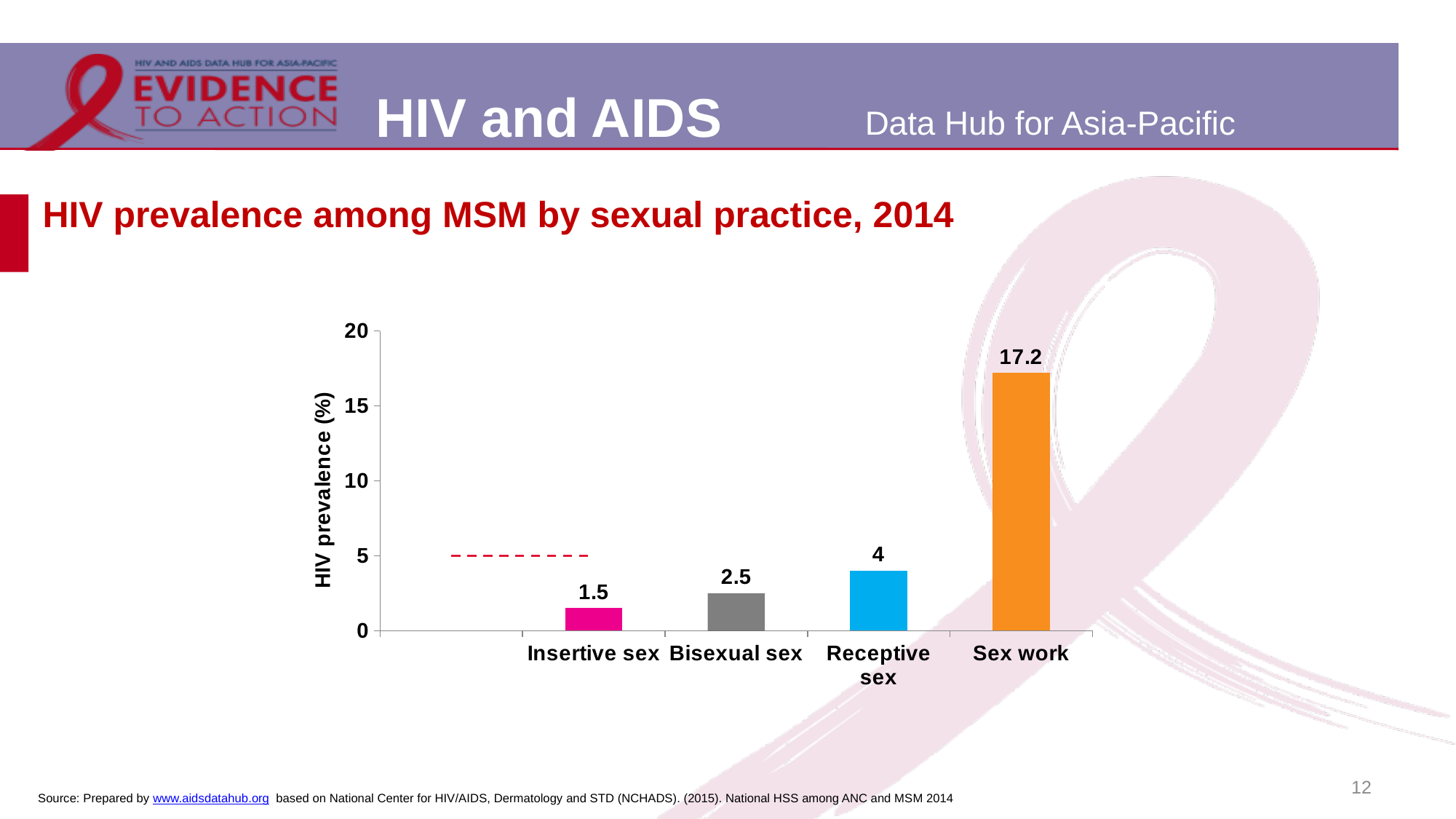
Is the value for Sex work greater or less than 15? greater What is the HIV prevalence for Receptive sex? 4 Which sexual practice has the highest HIV prevalence? Sex work What is the HIV prevalence for Sex work? 17.2 Which has a higher HIV prevalence, Receptive sex or Bisexual sex? Receptive sex How many sexual practice categories are shown in the chart? 4 What is the difference in HIV prevalence between Sex work and Receptive sex? 13.2 What is the HIV prevalence for Bisexual sex? 2.5 What is the difference in HIV prevalence between Bisexual sex and Insertive sex? 1 What is the HIV prevalence for Insertive sex? 1.5 Which sexual practice has the lowest HIV prevalence? Insertive sex What kind of chart is shown on the slide? Bar chart